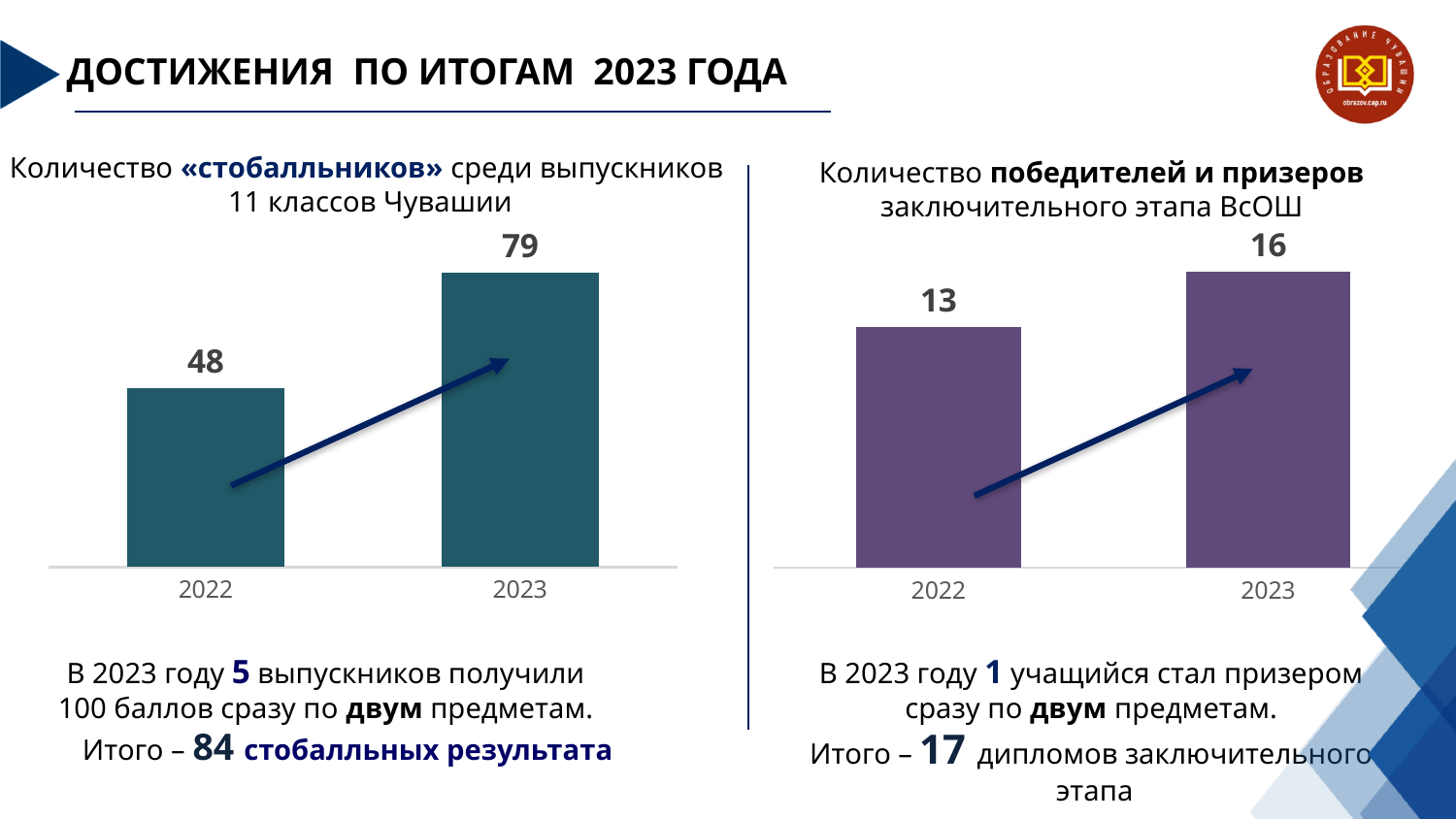
In the right chart (winners and prize-winners of VsOSh), which year has the lower value? 2022 What type of chart is the left chart (number of 100-point scorers)? bar chart How many categories (years) are shown in the right chart (winners and prize-winners of VsOSh)? 2 In the right chart (winners and prize-winners of VsOSh), what is the difference between the 2023 and 2022 values? 3 In the right chart (number of winners and prize-winners of the final stage of VsOSh), what is the value for 2022? 13 In the left chart (number of 100-point scorers), by how much did the value increase from 2022 to 2023? 31 In the left chart (number of 100-point scorers), which year has the higher value? 2023 In the left chart (number of 100-point scorers), what is the value for 2023? 79 In the left chart (number of 100-point scorers), do the values rise or fall from 2022 to 2023? rise In the left chart (number of 100-point scorers among 11th-grade graduates of Chuvashia), what is the value for 2022? 48 What colour are the bars in the right chart (winners and prize-winners of VsOSh)? purple In the right chart (winners and prize-winners of VsOSh), what is the value for 2023? 16